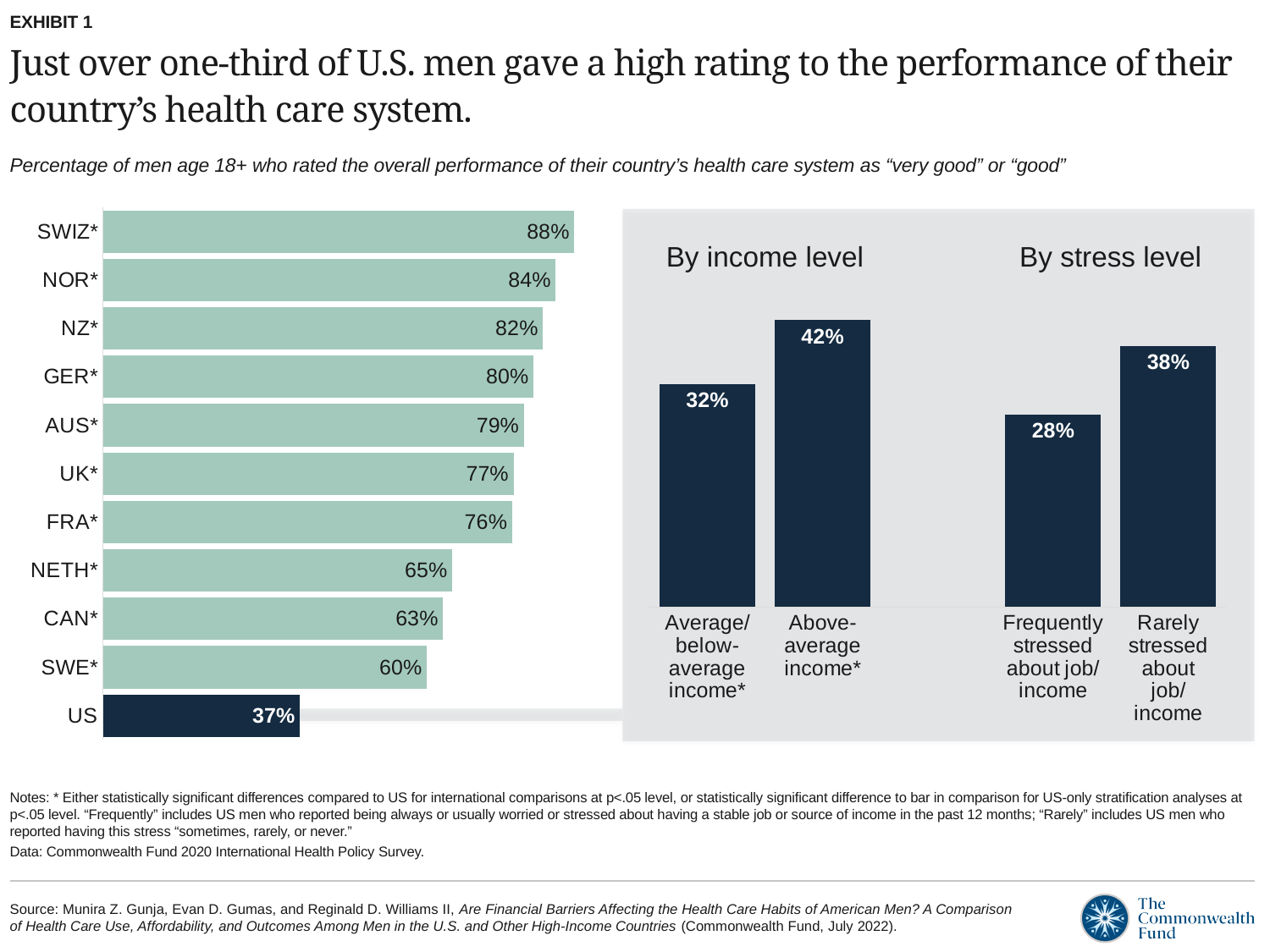
In the country bar chart on the left, which has a higher value, NETH or CAN? NETH* In the 'By stress level' chart, which group has the higher value, frequently stressed or rarely stressed? Rarely stressed about job/income In the country bar chart on the left, which country has the highest value? SWIZ* In the 'By income level' chart, what is the difference between above-average income and average/below-average income? 10 percentage points In the country bar chart on the left, what percentage of men in SWIZ rated their health care system as very good or good? 88% In the 'By stress level' chart, what is the value for men frequently stressed about job/income? 28% In the country bar chart on the left, what is the difference between the values for SWIZ and the US? 51 percentage points In the country bar chart on the left, which country has the lowest value? US In the country bar chart on the left, what is the value for the US? 37% In the 'By income level' chart, what is the value for above-average income? 42% What kind of chart is the chart on the left showing countries? Bar chart How many countries are shown in the bar chart on the left? 11